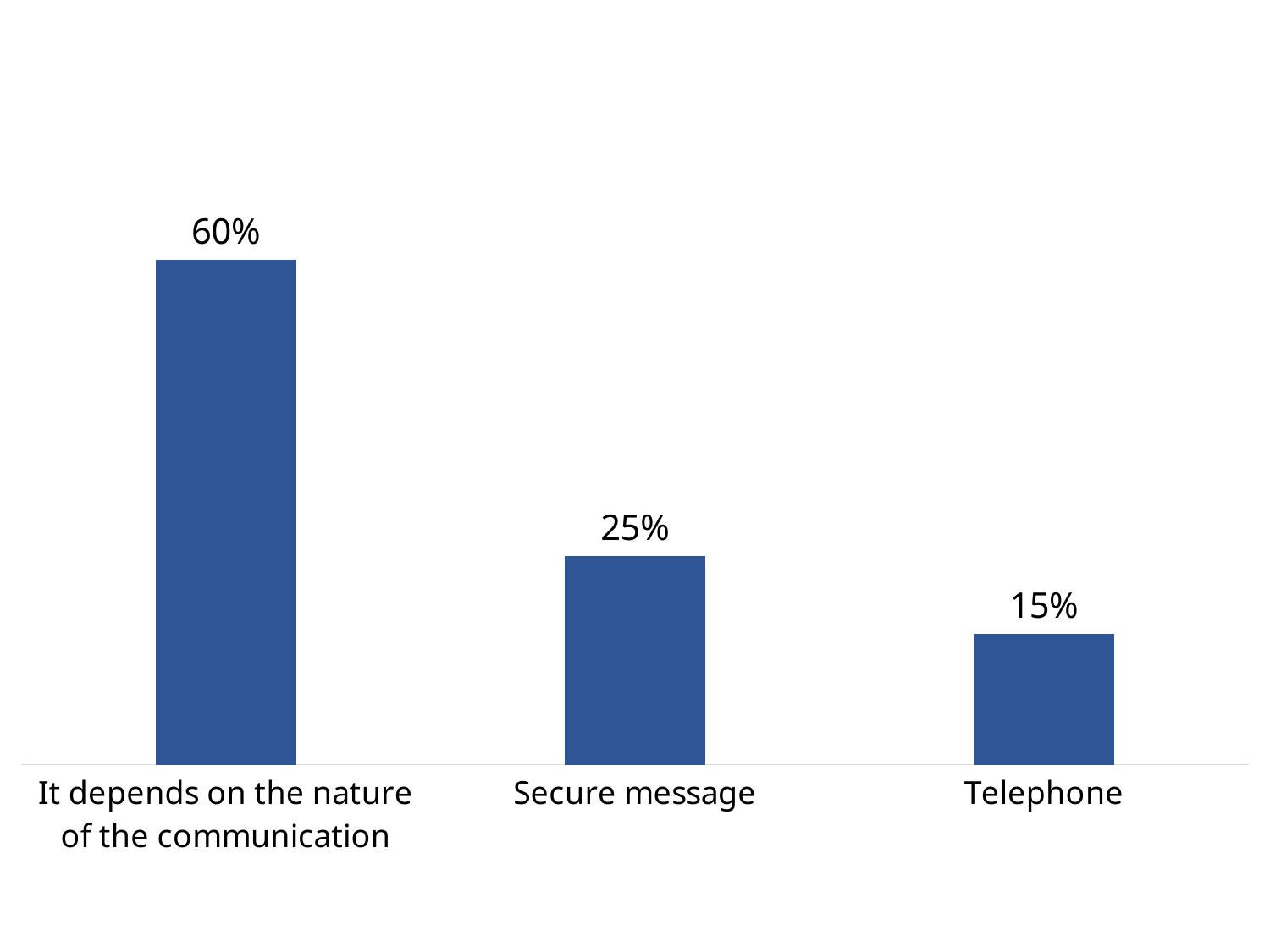
What is the difference between the values for "It depends on the nature of the communication" and "Secure message"? 35% What is the value for "It depends on the nature of the communication"? 60% Which category has the highest value? It depends on the nature of the communication What colour are the bars in the chart? Blue What is the value for "Telephone"? 15% What is the value for "Secure message"? 25% Which is larger, the value for "Secure message" or the value for "Telephone"? Secure message What is the difference between the values for "Secure message" and "Telephone"? 10% How many categories are shown in the chart? 3 What kind of chart is shown on the slide? Bar chart Which category has the lowest value? Telephone Do the values rise or fall from left to right along the x axis? Fall